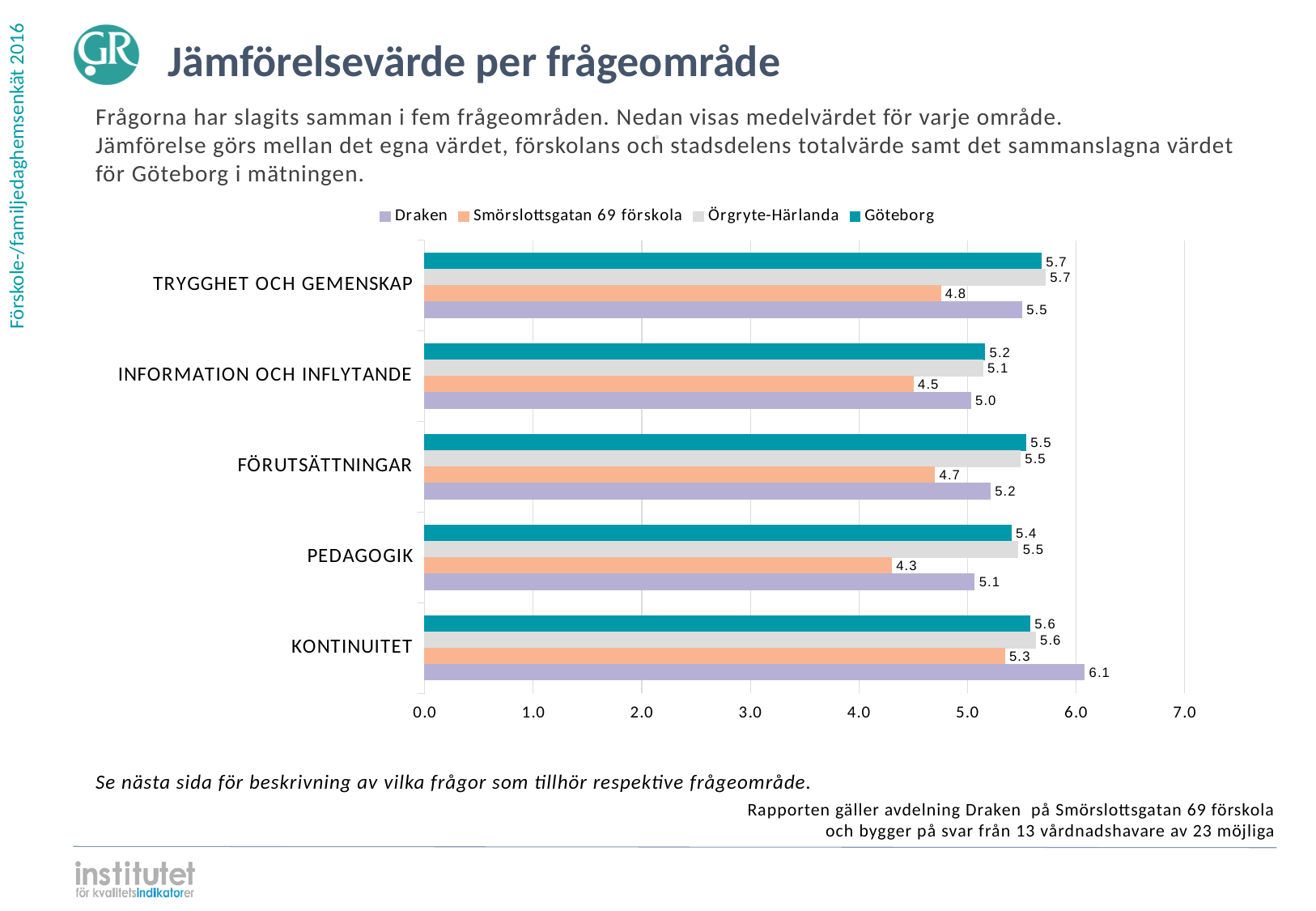
Which is larger in TRYGGHET OCH GEMENSKAP: the Draken value or the Smörslottsgatan 69 förskola value? Draken What is the value for Örgryte-Härlanda in TRYGGHET OCH GEMENSKAP? 5.7 What is the value for Göteborg in INFORMATION OCH INFLYTANDE? 5.2 What is the difference between the Draken value and the Smörslottsgatan 69 förskola value in FÖRUTSÄTTNINGAR? 0.5 How many question areas (categories) are shown on the chart? 5 What is the value for Smörslottsgatan 69 förskola in PEDAGOGIK? 4.3 What is the value for Draken in KONTINUITET? 6.1 In which category does Draken have its highest value? KONTINUITET In which category does Smörslottsgatan 69 förskola have its lowest value? PEDAGOGIK What kind of chart is shown on the slide? Bar chart Is the value for Draken in KONTINUITET greater or less than 6.0? greater How many series does the legend list? 4